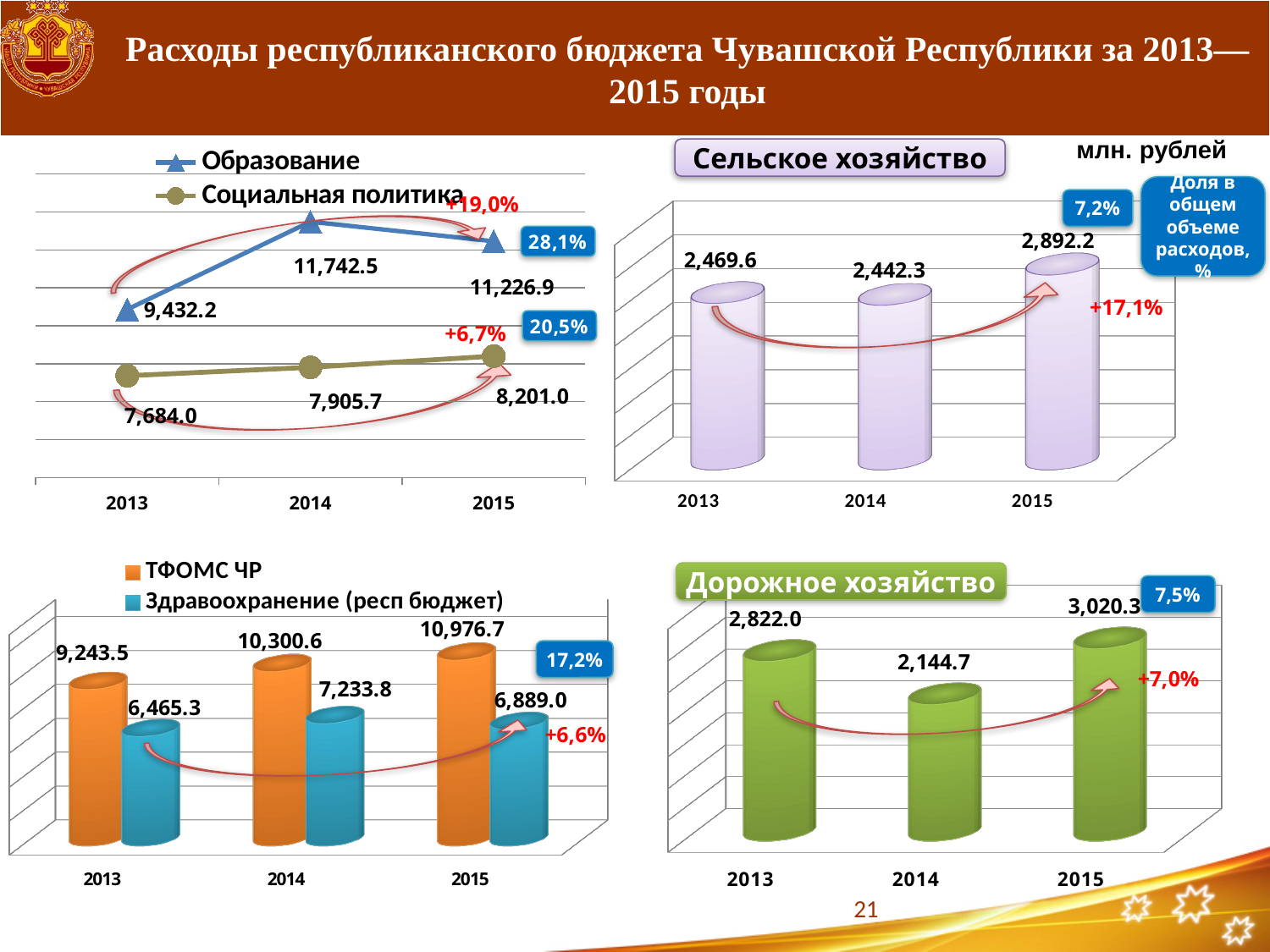
In the top-left line chart, do the values for Социальная политика rise or fall from 2013 to 2015? rise In the top-left line chart, what is the value for Образование in 2014? 11,742.5 In the bottom-left bar chart, what is the value for ТФОМС ЧР in 2015? 10,976.7 What kind of chart is the Дорожное хозяйство chart? bar chart In the Сельское хозяйство chart, which year has the lowest value? 2014 In the Сельское хозяйство chart, what is the difference between the 2015 and 2014 values? 449.9 In the top-left line chart, which year has the highest value for Образование? 2014 In the top-left line chart, how many series does the legend list? 2 In the Дорожное хозяйство chart, what is the value for 2014? 2,144.7 In the top-left line chart, what is the value for Социальная политика in 2013? 7,684.0 In the Сельское хозяйство chart, what is the value for 2015? 2,892.2 In the bottom-left bar chart, which is larger in 2014: ТФОМС ЧР or Здравоохранение (респ бюджет)? ТФОМС ЧР